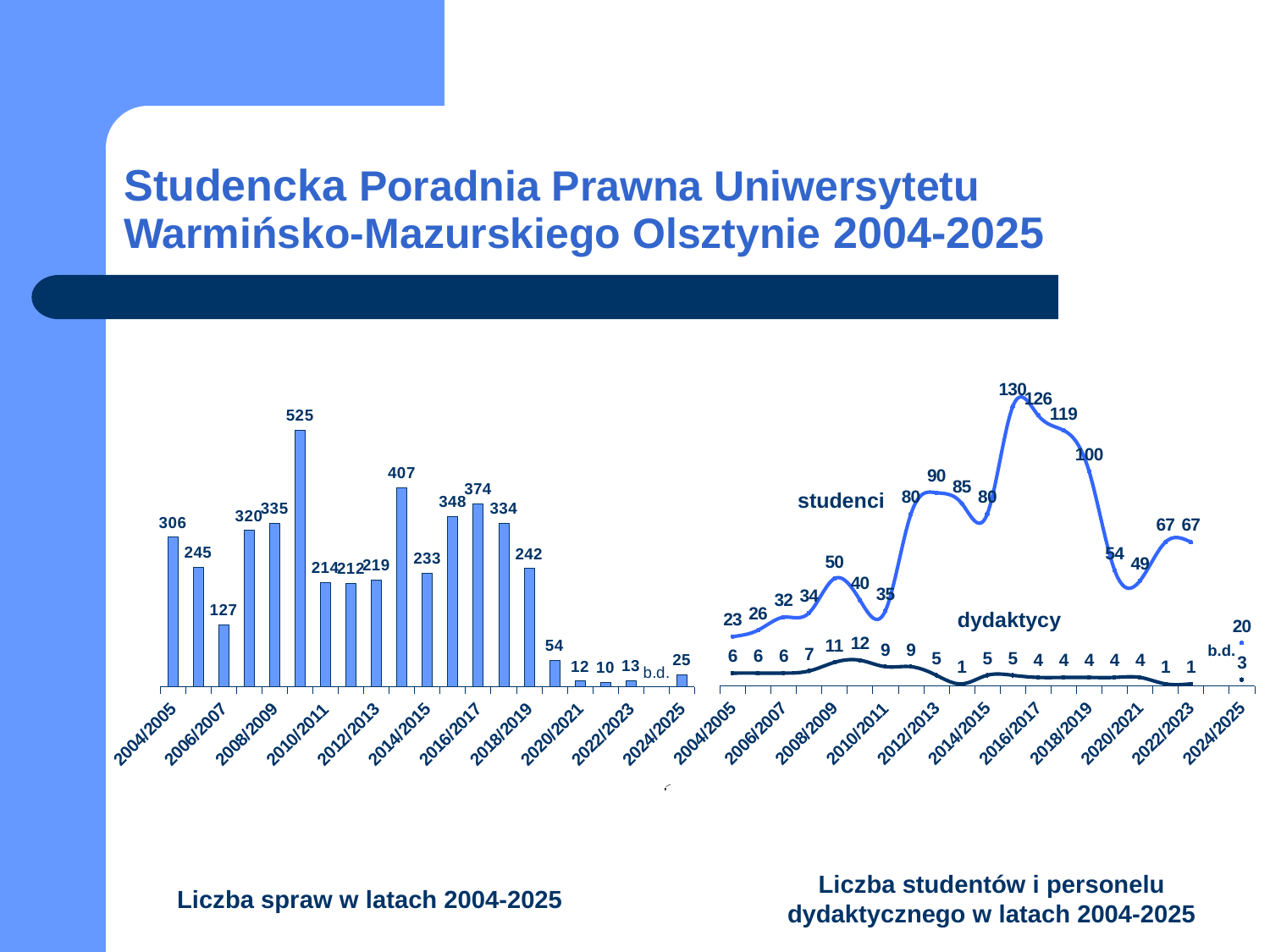
In the right chart (Liczba studentów i personelu dydaktycznego), what is the value for studenci in 2024/2025? 20 In the right chart (Liczba studentów i personelu dydaktycznego), what is the value for dydaktycy in 2009/2010? 12 In the right chart (Liczba studentów i personelu dydaktycznego), what is the value for studenci in 2015/2016? 130 In the left chart (Liczba spraw w latach 2004-2025), which is larger, the value for 2008/2009 or the value for 2014/2015? 2008/2009 In the left chart (Liczba spraw w latach 2004-2025), which year has the highest number of cases? 2009/2010 In the right chart (Liczba studentów i personelu dydaktycznego), how many series are plotted? 2 In the left chart (Liczba spraw w latach 2004-2025), what is the difference between the values for 2016/2017 and 2018/2019? 132 What type of chart is the left chart (Liczba spraw w latach 2004-2025)? bar chart In the left chart (Liczba spraw w latach 2004-2025), what is the value for 2006/2007? 127 In the right chart (Liczba studentów i personelu dydaktycznego), what is the difference between the studenci values for 2018/2019 and 2020/2021? 51 In the left chart (Liczba spraw w latach 2004-2025), what is shown for 2023/2024? b.d. In the left chart (Liczba spraw w latach 2004-2025), what is the value for 2004/2005? 306